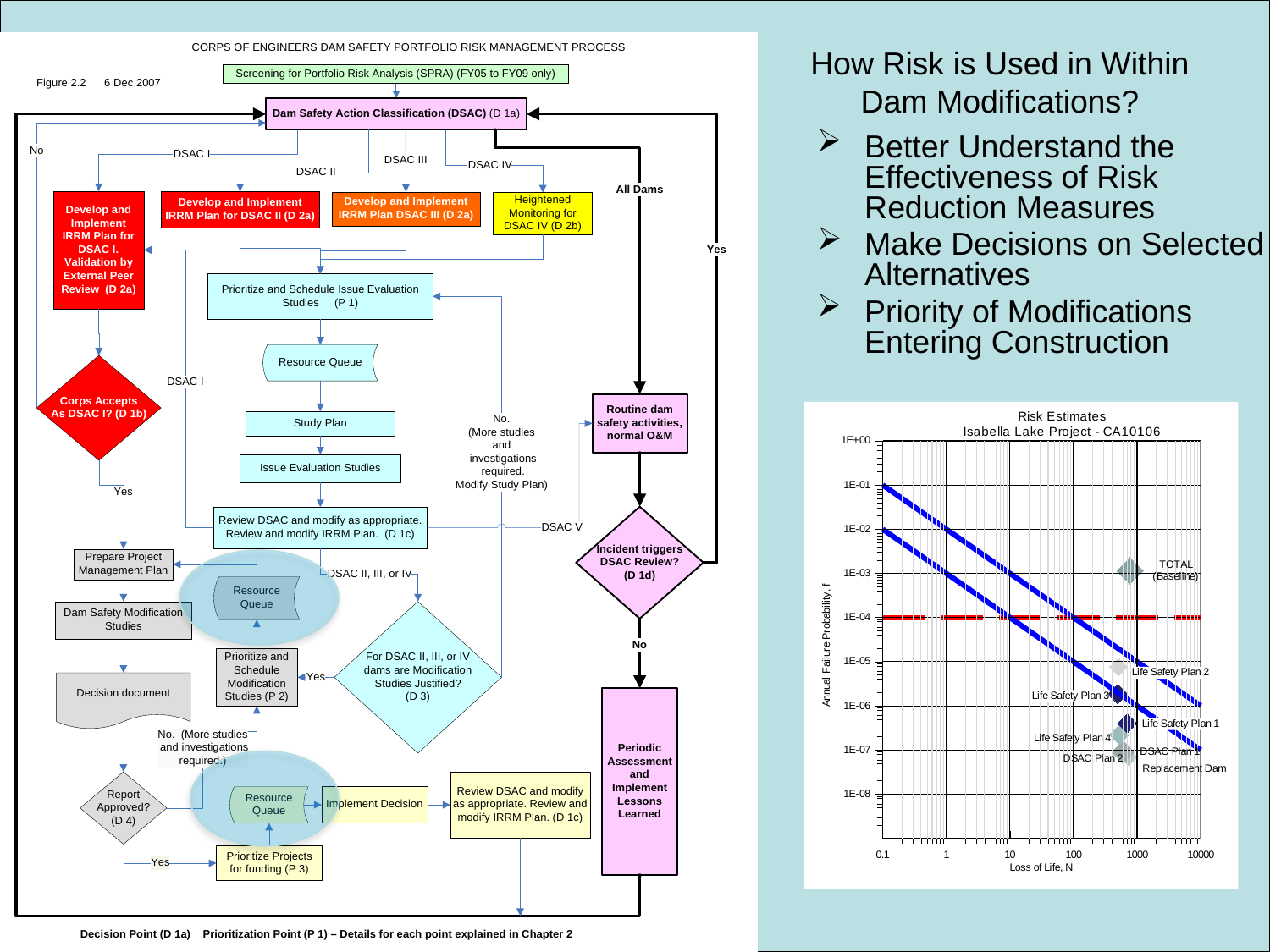
How many labeled data points are shown in the Risk Estimates chart? 8 In the Risk Estimates chart, which labeled point has the highest annual failure probability? TOTAL (Baseline) In the Risk Estimates chart, which has the higher annual failure probability, TOTAL (Baseline) or Life Safety Plan 3? TOTAL (Baseline) In the Risk Estimates chart, do the blue diagonal lines rise or fall as Loss of Life increases? fall In the Risk Estimates chart, is the annual failure probability for Life Safety Plan 2 greater or less than 1E-04? less In the Risk Estimates chart, at which annual failure probability is the red horizontal line drawn? 1E-04 In the Risk Estimates chart, is the annual failure probability for Life Safety Plan 1 greater or less than 1E-05? less In the Risk Estimates chart, what is the label of the vertical axis? Annual Failure Probability, f In the Risk Estimates chart, is the annual failure probability for TOTAL (Baseline) greater or less than 1E-04? greater What kind of chart is the 'Risk Estimates Isabella Lake Project - CA10106' chart? scatter chart What is the title of the chart on the right side of the slide? Risk Estimates Isabella Lake Project - CA10106